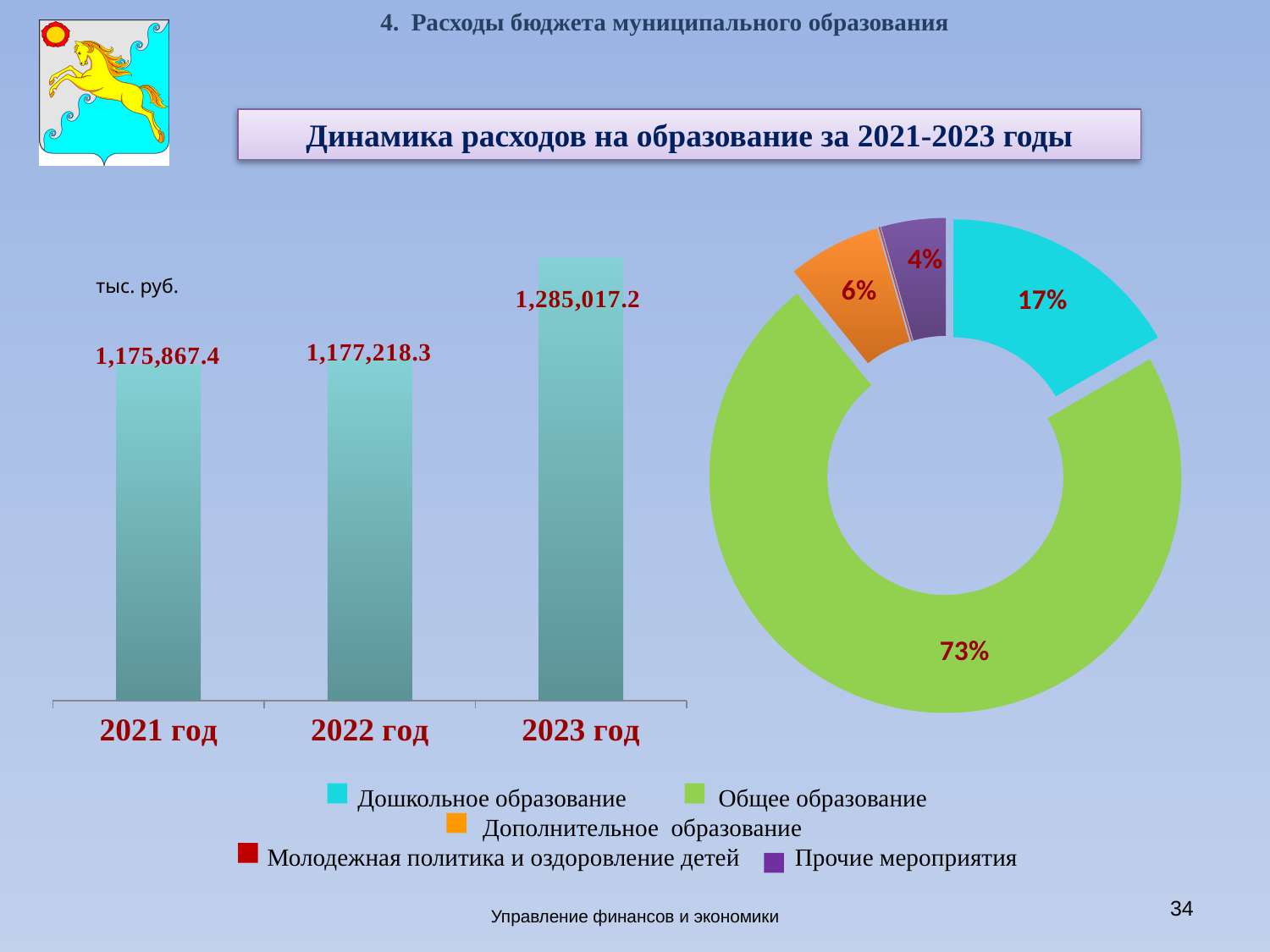
What kind of chart is the chart on the left of the slide? bar chart On the bar chart on the left, do the values rise or fall from 2021 год to 2023 год? rise How many entries does the legend below the donut chart list? 5 On the bar chart on the left, what is the value for 2023 год? 1,285,017.2 On the bar chart on the left, how many years are shown? 3 On the bar chart on the left, what is the value for 2022 год? 1,177,218.3 On the donut chart on the right, what share does Общее образование have? 73% On the bar chart on the left, which year has the highest value? 2023 год On the bar chart on the left, which year has the lowest value? 2021 год On the bar chart on the left, what is the difference between the values for 2023 год and 2022 год? 107,798.9 On the donut chart on the right, what share does Дошкольное образование have? 17% On the bar chart on the left, what is the value for 2021 год? 1,175,867.4